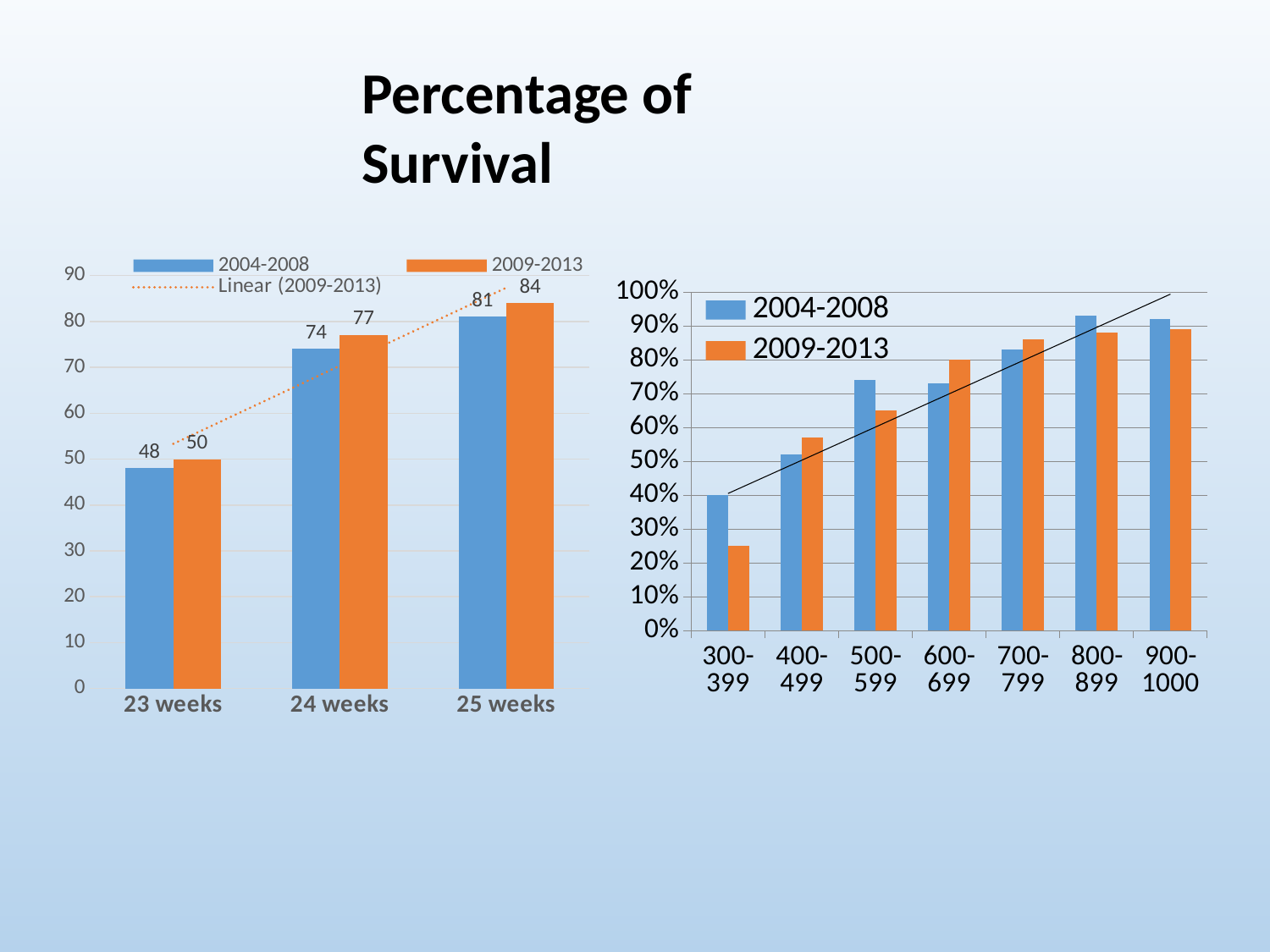
On the left chart, what is the difference between the 2009-2013 and 2004-2008 values at 24 weeks? 3 On the right chart, is the value for 2004-2008 in the 900-1000 category greater or less than 80%? greater On the right chart, is the value for 2009-2013 in the 300-399 category greater or less than 30%? less On the left chart, which category has the highest value for 2004-2008? 25 weeks On the left chart, what is the value for 2009-2013 at 25 weeks? 84 On the left chart, which is larger at 25 weeks: 2004-2008 or 2009-2013? 2009-2013 What kind of chart is the right chart? bar chart On the left chart, what is the value for 2009-2013 at 24 weeks? 77 On the right chart, how many weight categories are shown on the x axis? 7 On the left chart, which category has the lowest value for 2009-2013? 23 weeks On the left chart, how many entries does the legend list? 3 On the left chart, what is the value for 2004-2008 at 23 weeks? 48